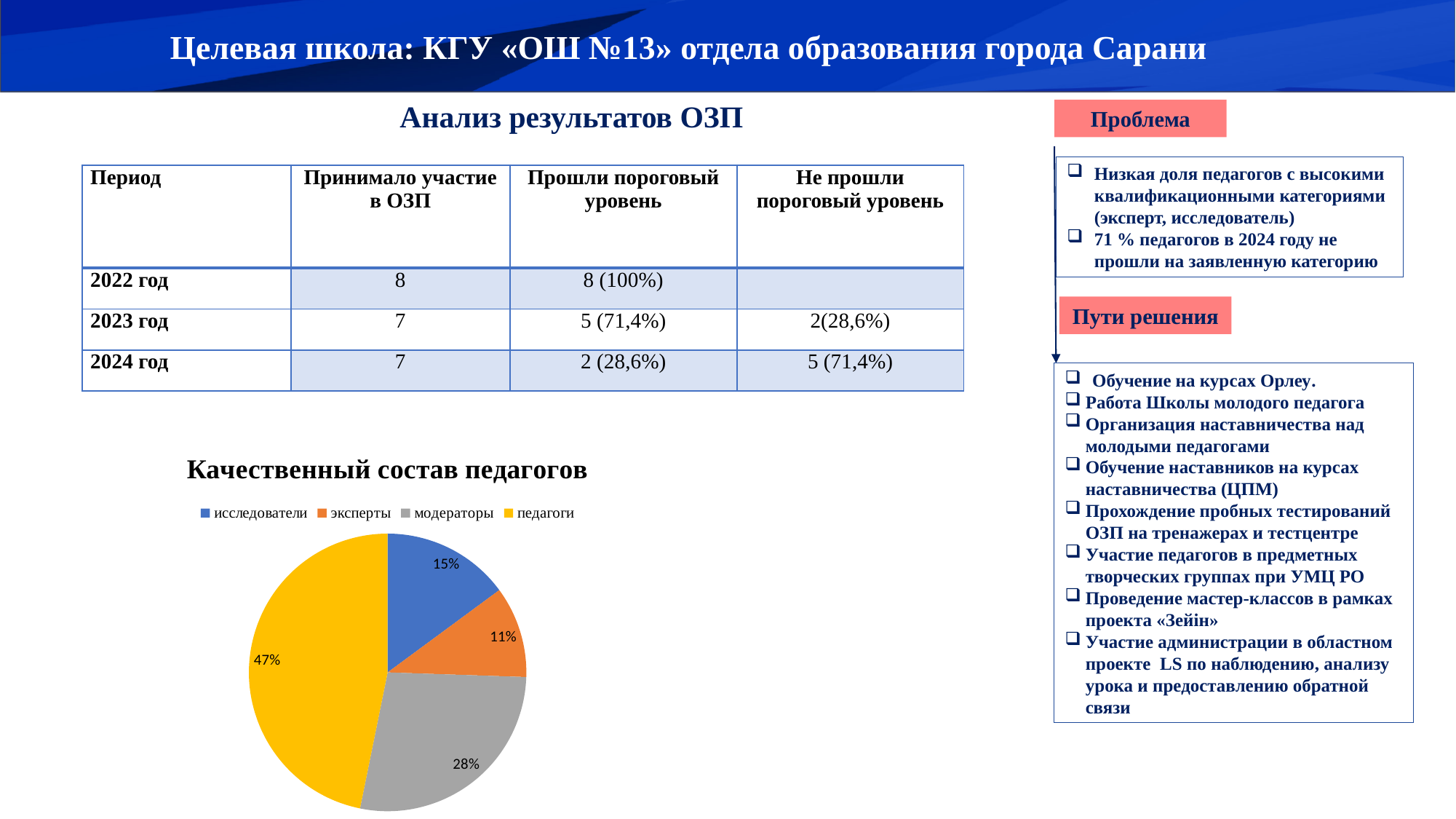
Which category has the largest slice in the pie chart? педагоги What is the value shown for 'исследователи' in the pie chart? 15% What is the value shown for 'эксперты' in the pie chart? 11% Which colour represents 'модераторы' in the pie chart? grey What share of the pie chart does the 'педагоги' slice represent? 47% Which is larger in the pie chart: 'исследователи' or 'эксперты'? исследователи What type of chart is shown on the slide? pie chart What is the value shown for 'модераторы' in the pie chart? 28% How many categories are shown in the pie chart? 4 What is the difference between the 'педагоги' and 'модераторы' shares in the pie chart? 19% What is the title of the pie chart? Качественный состав педагогов Which category has the smallest slice in the pie chart? эксперты